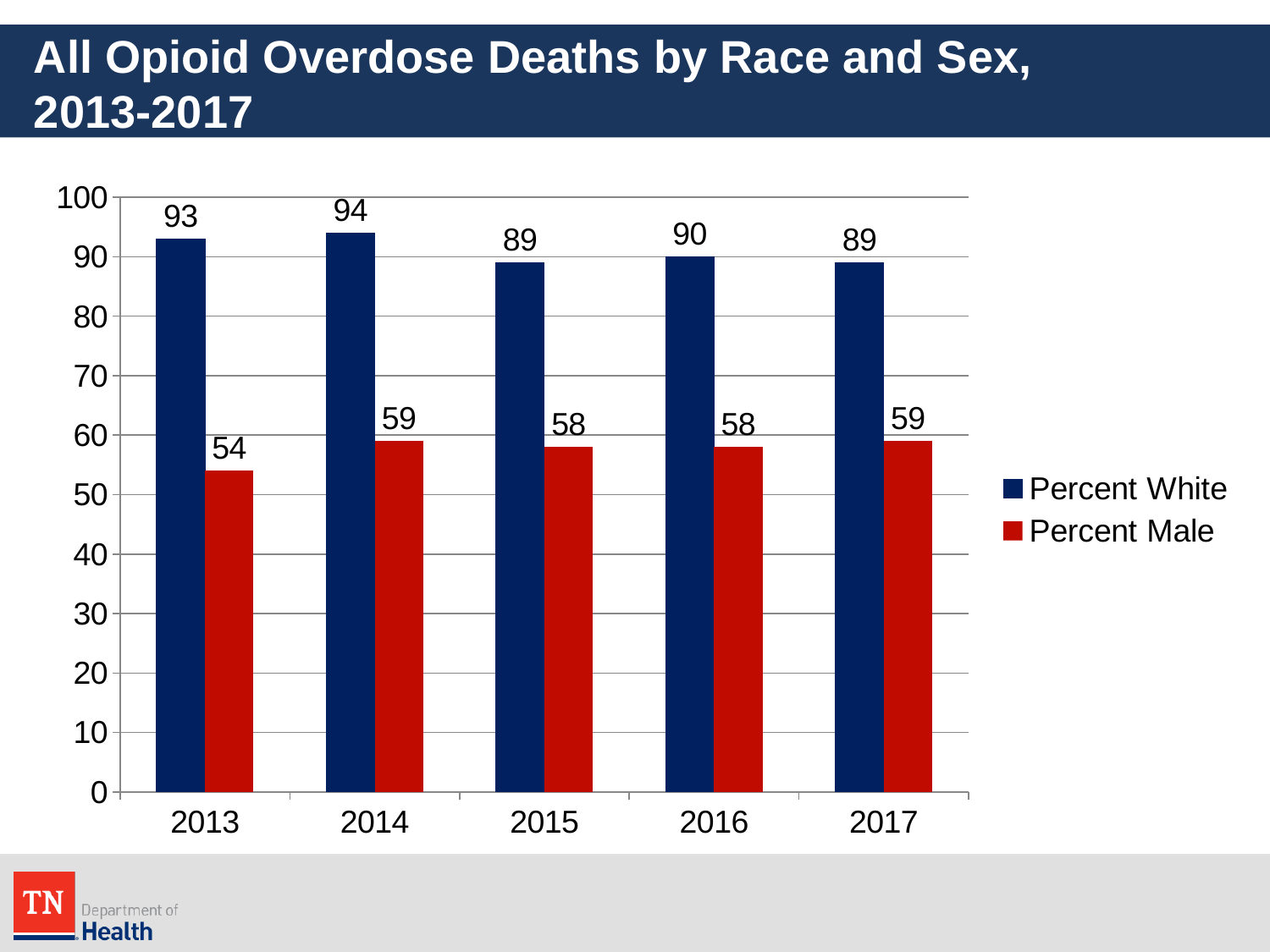
Is the Percent Male value for 2015 greater or less than 50? greater What is the Percent White value for 2013? 93 How many series does the legend list? 2 How many years are shown on the x axis? 5 What is the difference between Percent White and Percent Male in 2017? 30 What colour are the Percent Male bars? Red What kind of chart is shown on the slide? Bar chart Which is larger in 2014: Percent White or Percent Male? Percent White In which year is the Percent White value highest? 2014 In which year is the Percent Male value lowest? 2013 What is the Percent Male value for 2013? 54 What is the Percent Male value for 2016? 58